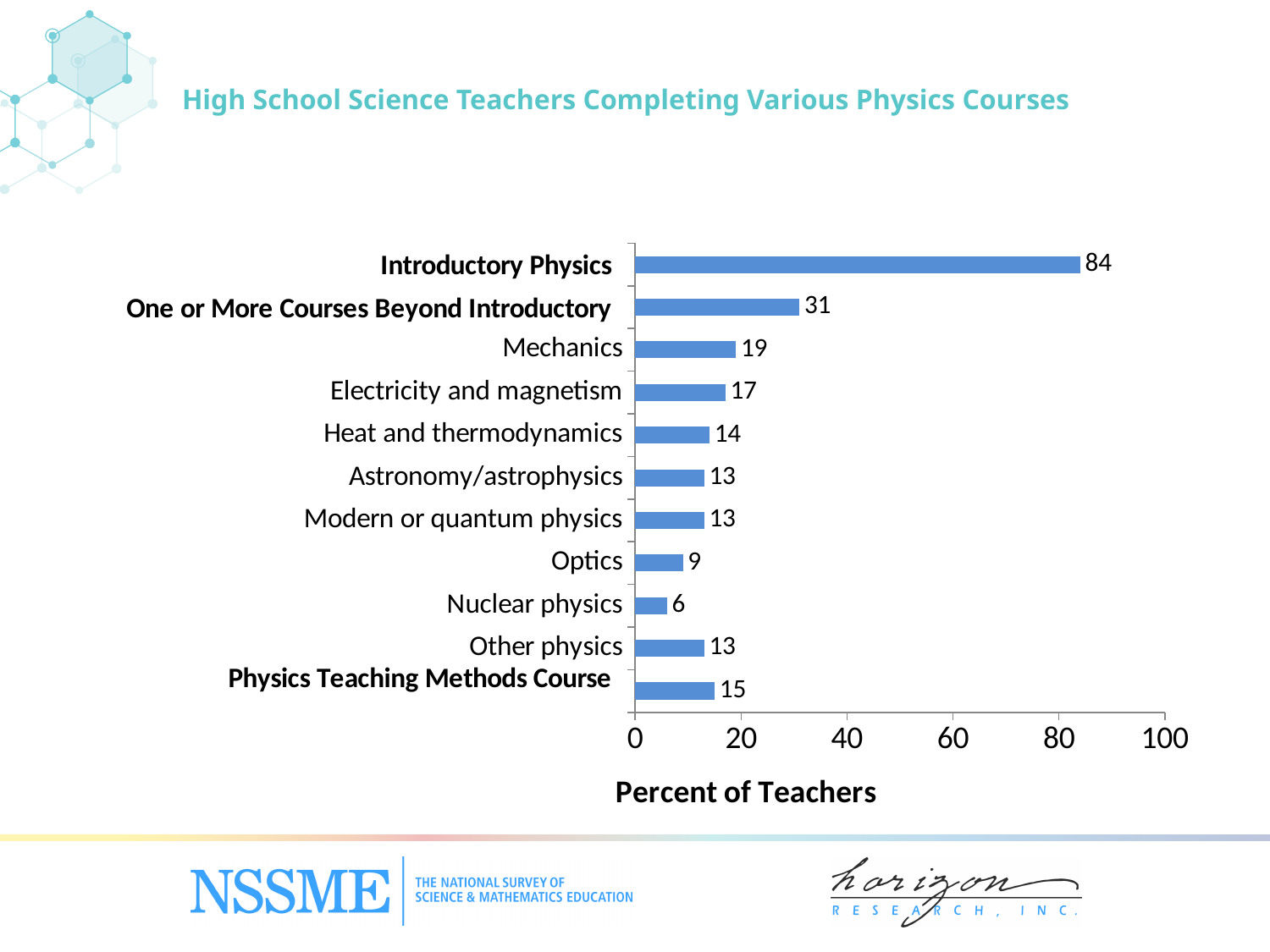
What is the label of the horizontal axis? Percent of Teachers How many categories are shown in the chart? 11 What kind of chart is shown on the slide? Bar chart Which is larger, Heat and thermodynamics or Astronomy/astrophysics? Heat and thermodynamics What percent of teachers completed Introductory Physics? 84 What is the value for Physics Teaching Methods Course? 15 Which category has the lowest value? Nuclear physics What is the value for Mechanics? 19 Which category has the highest value? Introductory Physics What is the value for Nuclear physics? 6 What is the difference between Electricity and magnetism and Optics? 8 What is the difference between Introductory Physics and One or More Courses Beyond Introductory? 53